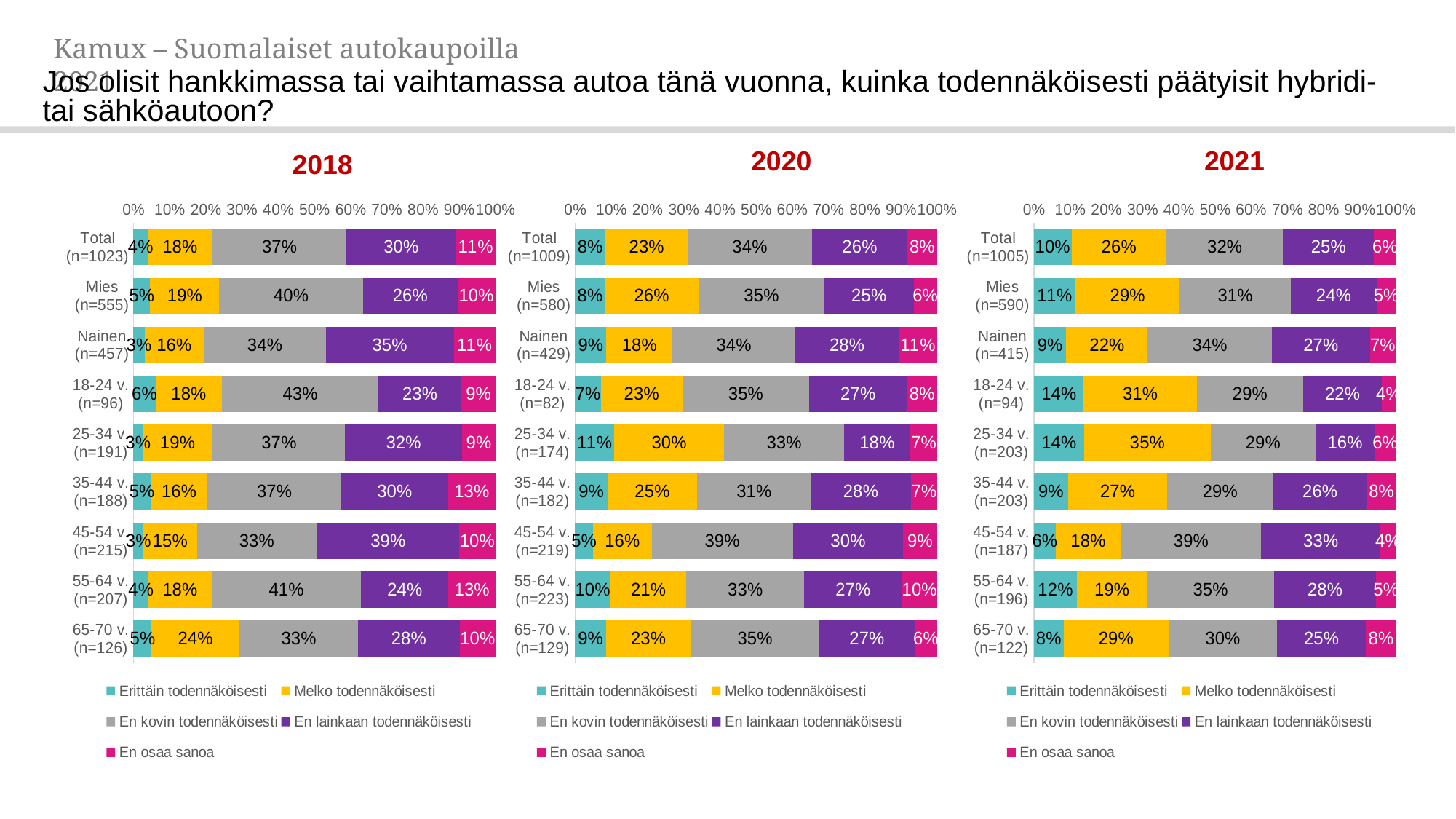
In the 2021 chart, which category has the highest value for "Melko todennäköisesti"? 25-34 v. (n=203) What is the title of the middle chart on the slide? 2020 In the 2020 chart, which category has the lowest value for "Erittäin todennäköisesti"? 45-54 v. (n=219) In the 2020 chart, what is the value of "Erittäin todennäköisesti" for 25-34 v. (n=174)? 11% How many series does the legend of the 2021 chart list? 5 What kind of chart is the 2018 chart? Stacked bar chart How many categories (bars) does the 2020 chart show? 9 In the 2018 chart, which category has the highest value for "En lainkaan todennäköisesti"? 45-54 v. (n=215) In the 2018 chart, what is the value of "En kovin todennäköisesti" for Total (n=1023)? 37% In the 2021 chart, what is the value of "Melko todennäköisesti" for 18-24 v. (n=94)? 31% In the 2020 chart, what is the difference between the "Melko todennäköisesti" values for Mies (n=580) and Nainen (n=429)? 8 percentage points In the 2021 chart, which has the larger "En kovin todennäköisesti" value: 45-54 v. (n=187) or 65-70 v. (n=122)? 45-54 v. (n=187)